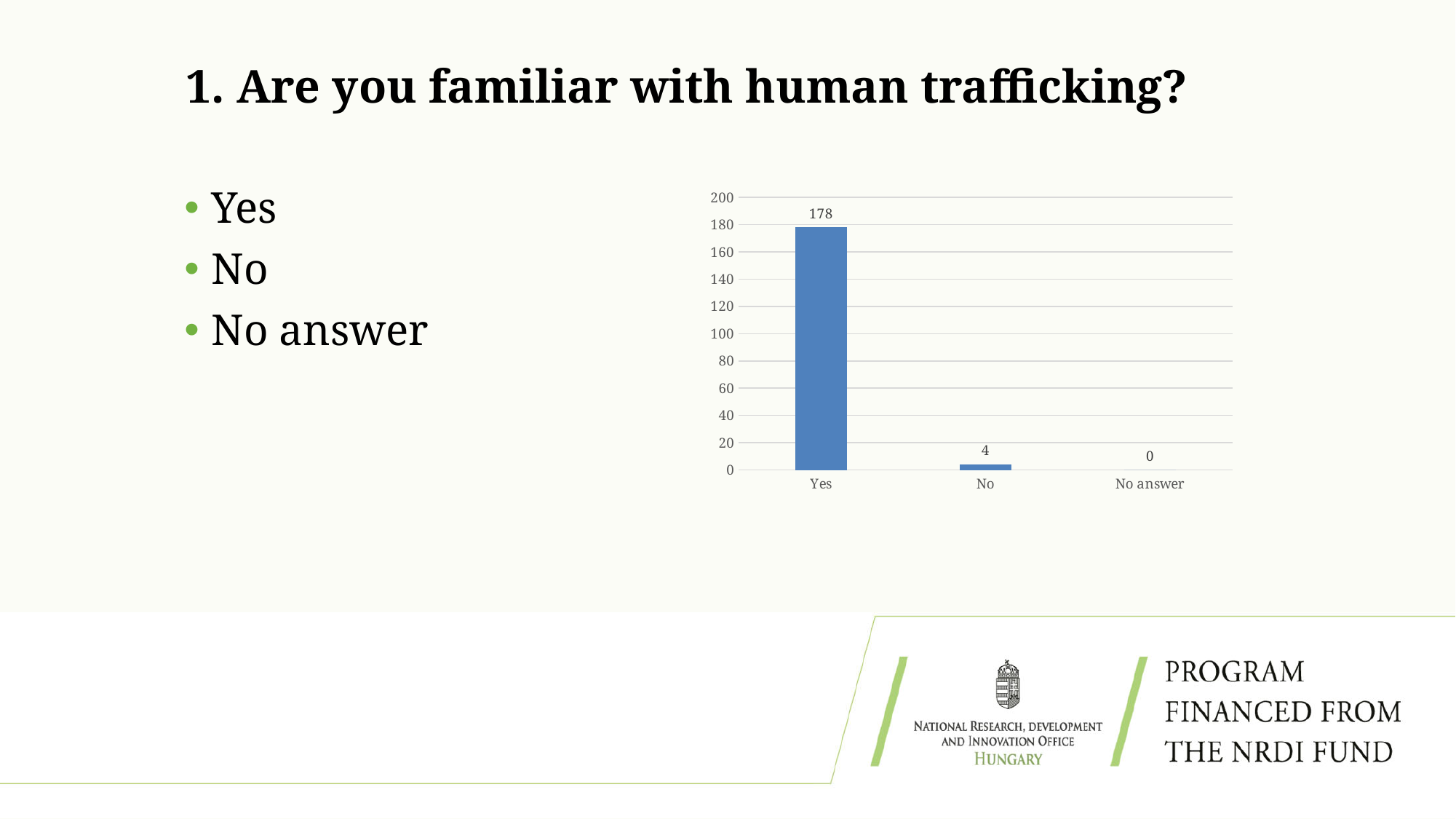
Which is larger, the value for No or the value for No answer? No What is the difference between the values for Yes and No? 174 What is the highest value shown on the vertical axis? 200 What is the value for No? 4 Which category has the lowest value? No answer What kind of chart is shown on the slide? bar chart How many categories are shown on the x axis? 3 Which category has the highest value? Yes What is the value for No answer? 0 Is the value for Yes greater or less than 160? greater Do the values rise or fall from Yes to No answer along the x axis? fall What is the value for Yes? 178